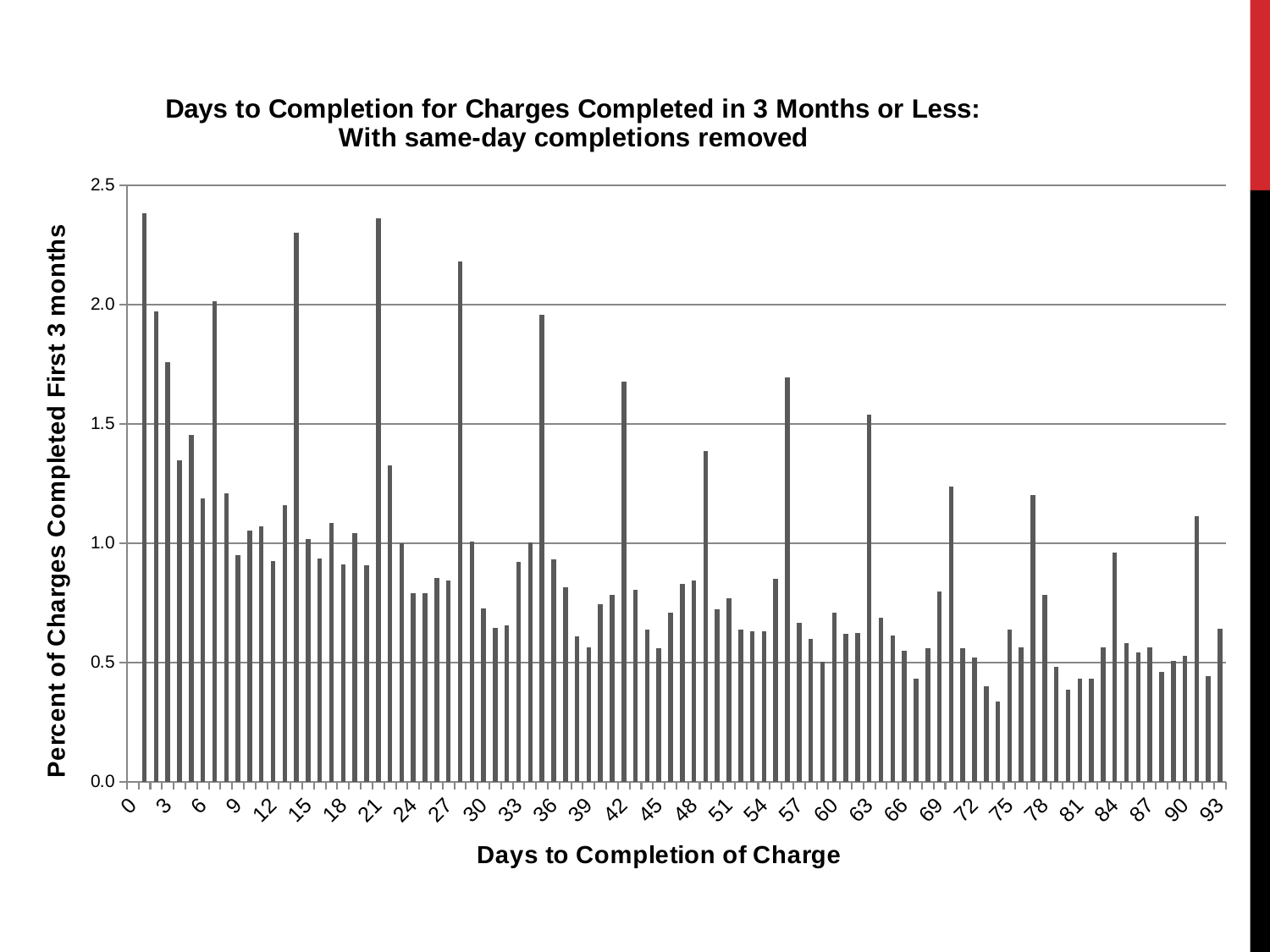
Is the value for day 42 greater or less than 1.5? greater Is the value for day 56 greater or less than 1.5? greater Overall, do the values rise or fall as the days to completion increase along the x axis? fall What is the label of the x axis? Days to Completion of Charge Is the value for day 70 greater or less than 1.0? greater What kind of chart is shown on the slide? bar chart What is the title of the chart? Days to Completion for Charges Completed in 3 Months or Less: With same-day completions removed